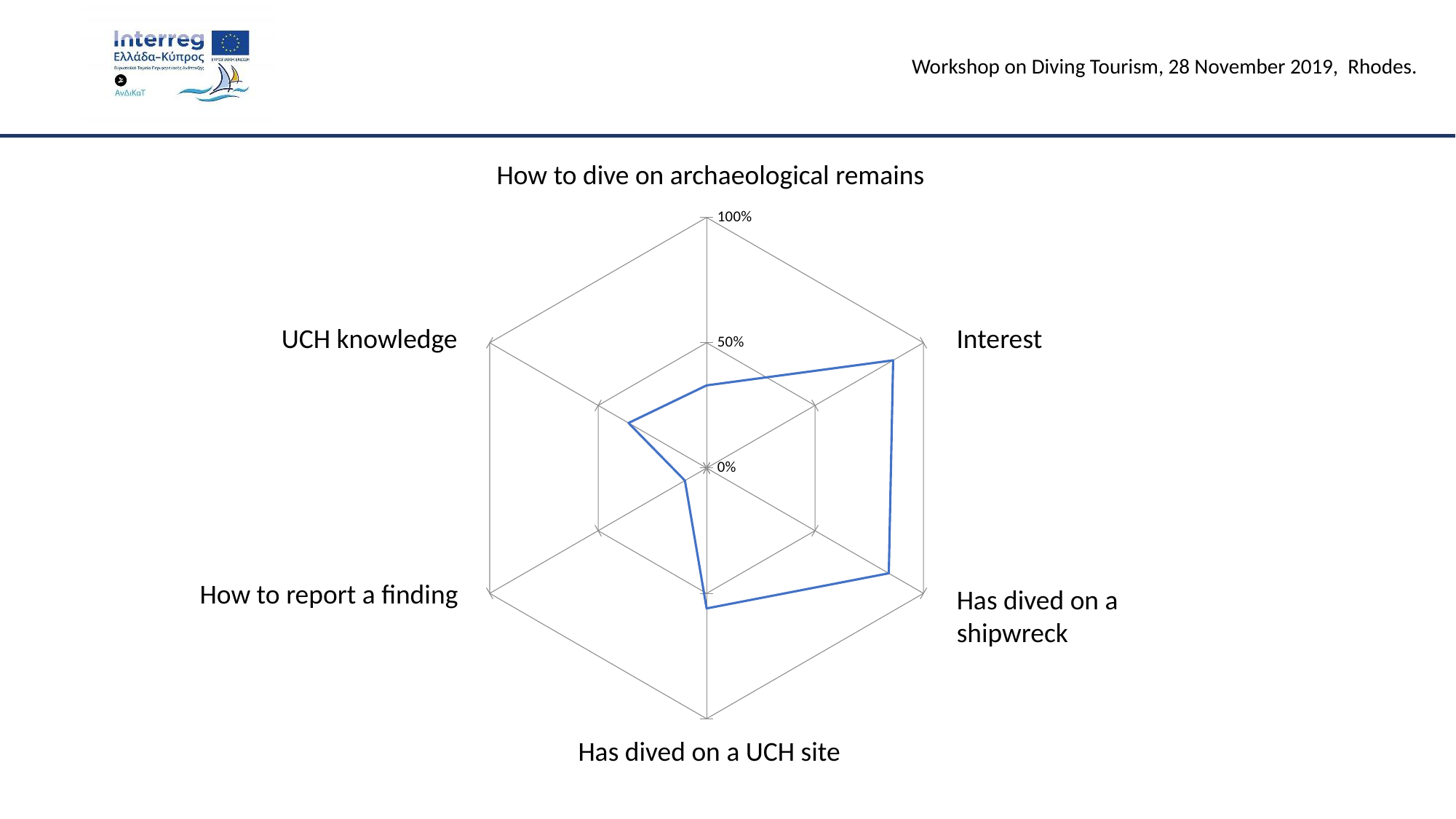
Which category has the lowest value on the radar chart? How to report a finding Which is larger, the value for Has dived on a UCH site or the value for How to report a finding? Has dived on a UCH site Is the value for How to report a finding greater or less than 50%? less Is the value for Interest greater or less than 50%? greater How many categories (axes) does the radar chart have? 6 Which is larger, the value for Interest or the value for How to report a finding? Interest What kind of chart is shown on the slide? Radar chart How many data series are plotted on the radar chart? 1 What is the maximum value shown on the radar chart's axis scale? 100% Is the value for Has dived on a shipwreck greater or less than 50%? greater